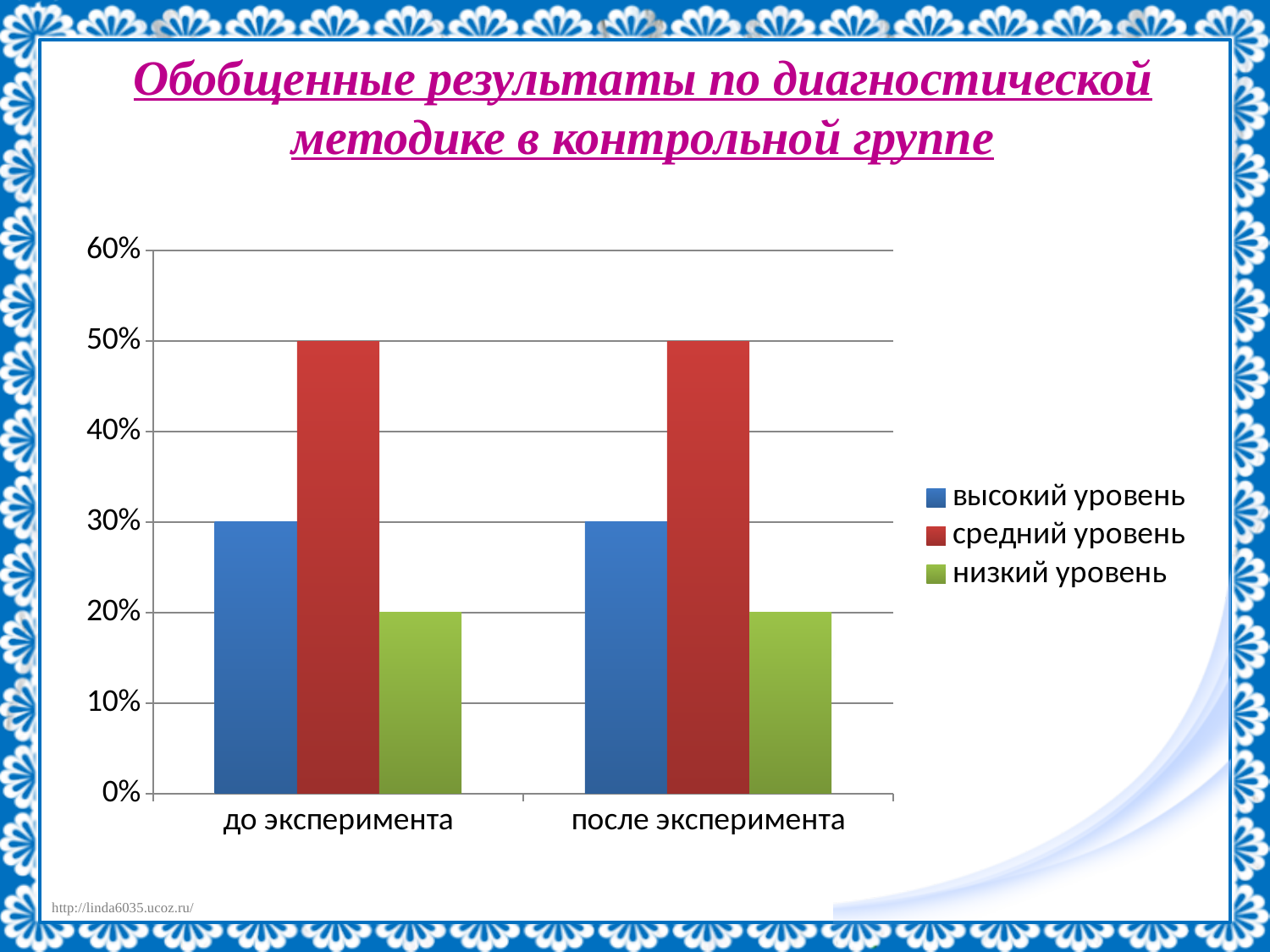
How many categories are shown on the x axis? 2 Does the value for высокий уровень change from до эксперимента to после эксперимента? No, it stays at 30% How many series does the legend list? 3 What is the value for высокий уровень in the до эксперимента category? 30% What kind of chart is shown on the slide? bar chart Which series has the lowest value in the до эксперимента category? низкий уровень Which is larger in the после эксперимента category: высокий уровень or низкий уровень? высокий уровень What colour represents средний уровень in the legend? red What is the value for низкий уровень in the до эксперимента category? 20% What is the value for средний уровень in the после эксперимента category? 50% What is the difference between средний уровень and низкий уровень in the до эксперимента category? 30% Which series has the highest value in the после эксперимента category? средний уровень